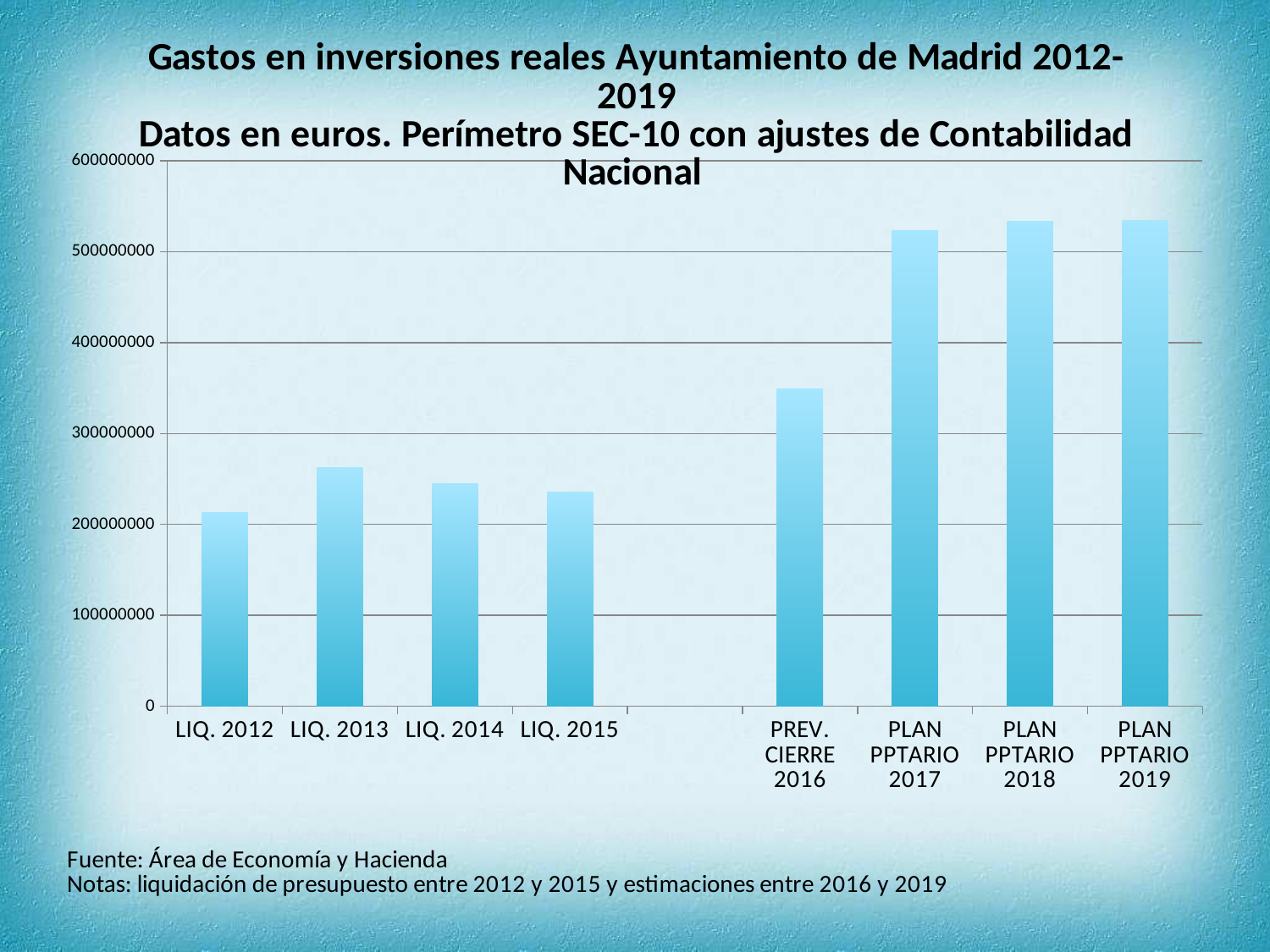
Is the value for PLAN PPTARIO 2019 greater or less than 600000000? less Which is larger, the value for PREV. CIERRE 2016 or the value for PLAN PPTARIO 2017? PLAN PPTARIO 2017 What kind of chart is shown on the slide? Bar chart Is the value for LIQ. 2013 greater or less than 300000000? less How many bars are plotted in the chart? 8 Is the value for LIQ. 2012 greater or less than 200000000? greater Which category has the lowest value in the chart? LIQ. 2012 Which is larger, the value for LIQ. 2013 or the value for LIQ. 2014? LIQ. 2013 Do the values rise or fall from LIQ. 2013 to LIQ. 2015? fall According to the note on the slide, what is the source of the data? Área de Economía y Hacienda